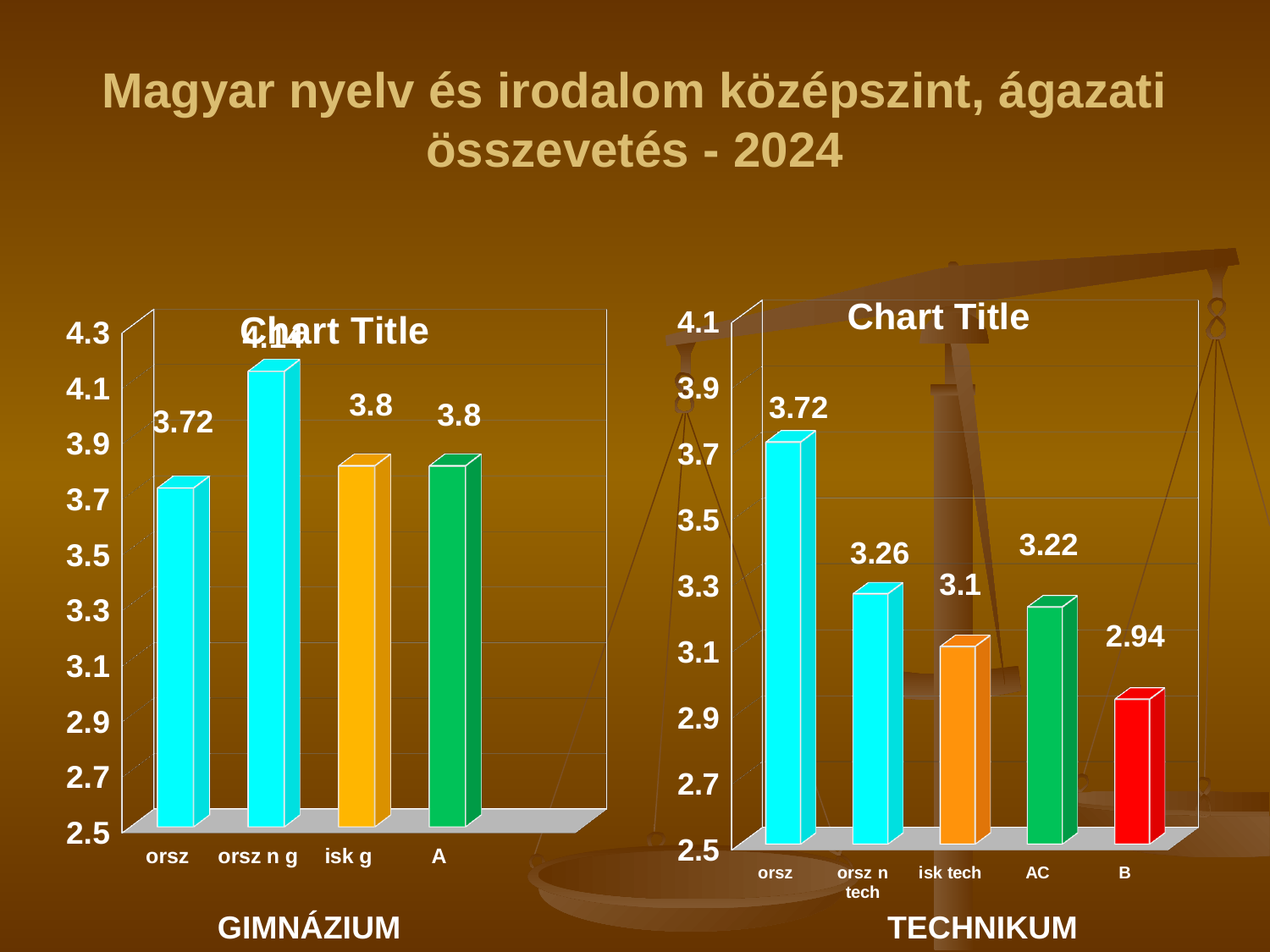
In the right chart (TECHNIKUM), which category has the highest value? orsz In the left chart (GIMNÁZIUM), what is the value for orsz n g? 4.14 In the left chart (GIMNÁZIUM), which category has the lowest value? orsz In the right chart (TECHNIKUM), what is the value for AC? 3.22 How many bars are in the right chart (TECHNIKUM)? 5 In the right chart (TECHNIKUM), which is larger, orsz n tech or isk tech? orsz n tech In the left chart (GIMNÁZIUM), what is the value for isk g? 3.8 In the right chart (TECHNIKUM), what is the difference between orsz and B? 0.78 In the left chart (GIMNÁZIUM), what is the difference between orsz n g and orsz? 0.42 In the right chart (TECHNIKUM), which category has the lowest value? B In the right chart (TECHNIKUM), what is the value for B? 2.94 What type of chart is the left chart (GIMNÁZIUM)? bar chart